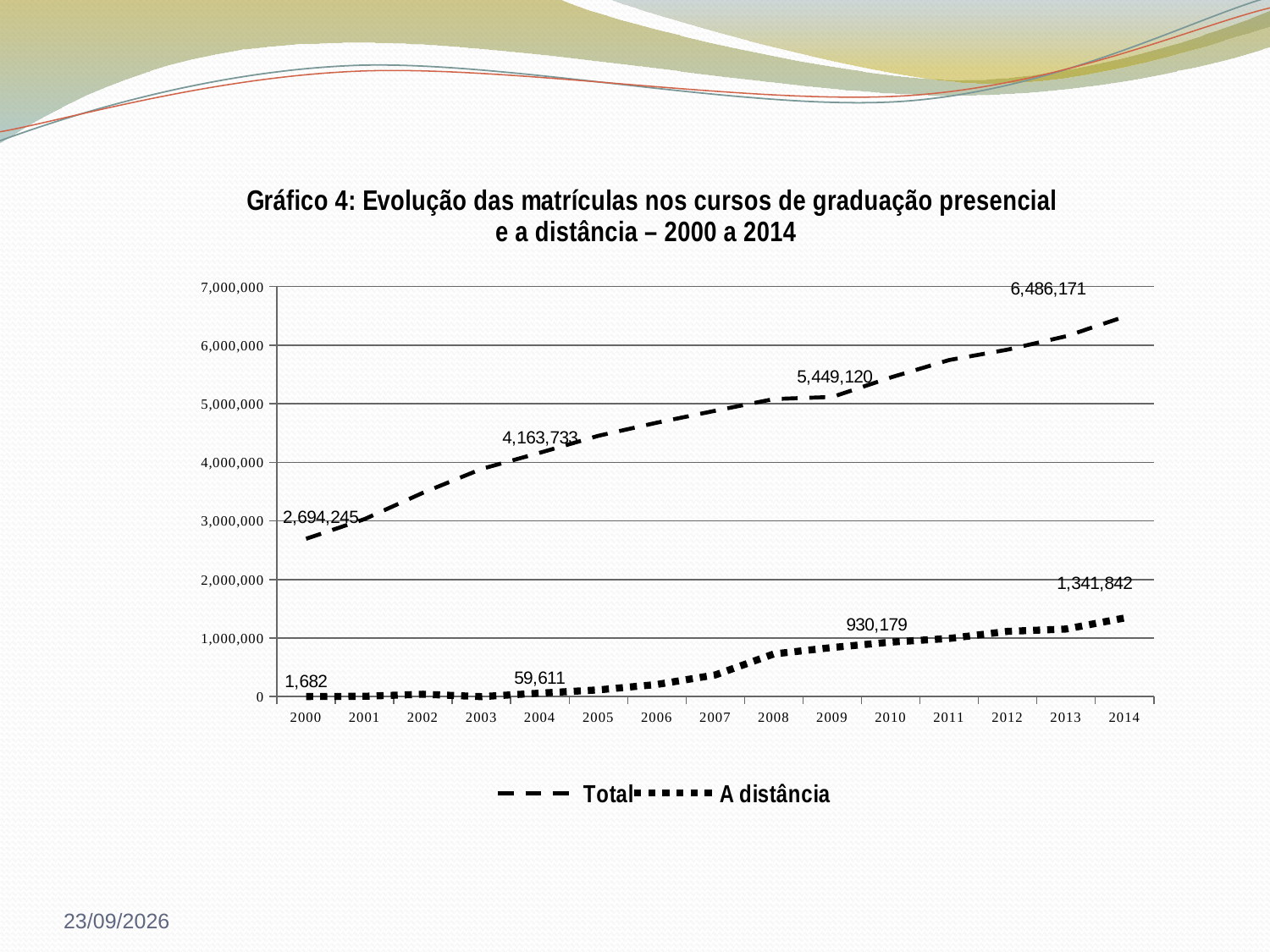
How many years are shown on the x axis? 15 Is the Total value for 2012 greater or less than 5,000,000? greater What is the value of the Total series in 2000? 2,694,245 What is the value of the Total series in 2014? 6,486,171 What is the value of the Total series in 2004? 4,163,733 What kind of chart is shown on the slide? line chart How many series does the legend list? 2 What is the difference between the Total values in 2014 and 2000? 3,791,926 Which series has the higher value in 2009, Total or A distância? Total What is the value of the A distância series in 2000? 1,682